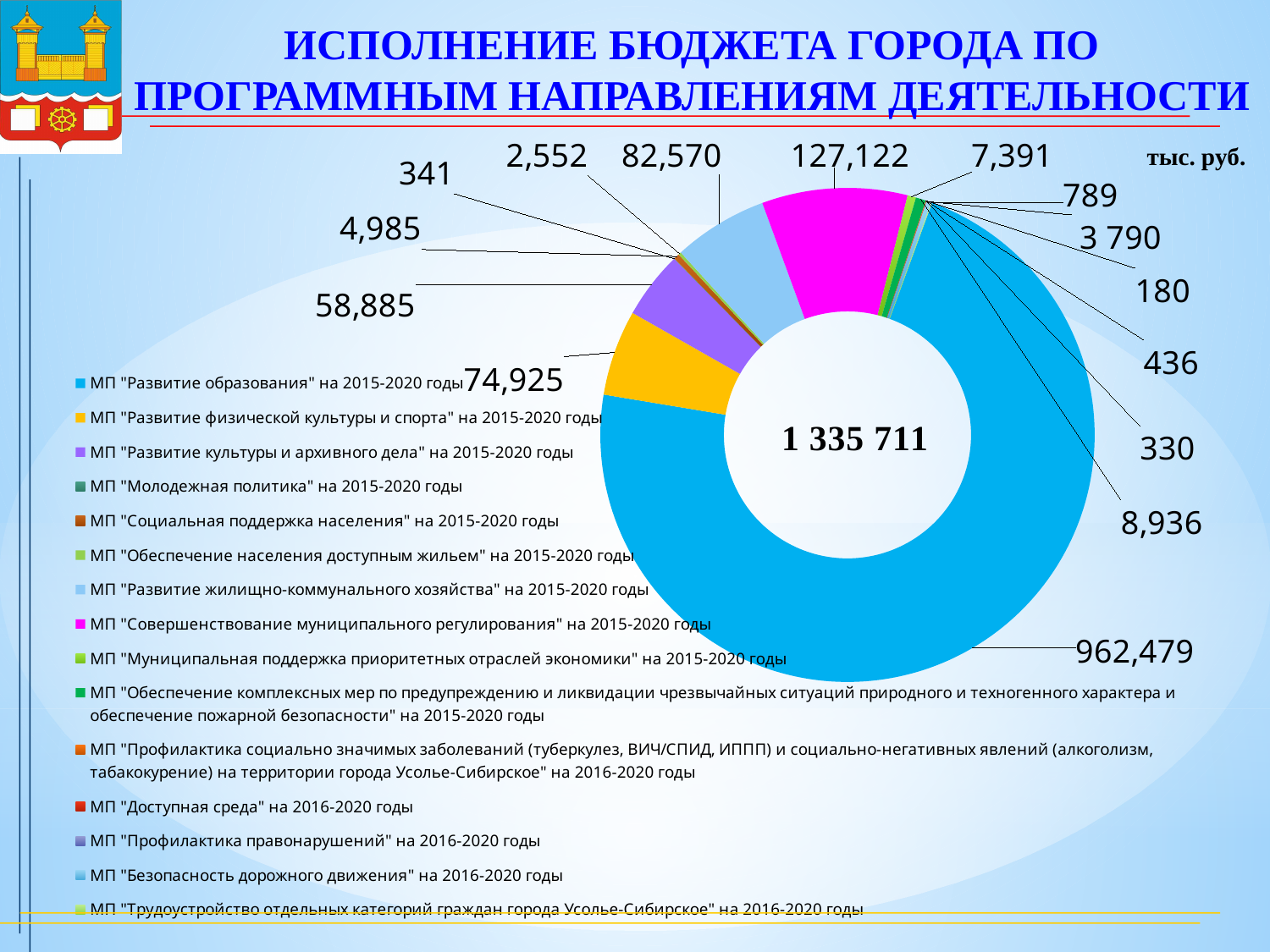
What is the smallest value printed on the chart? 180 What is the value for МП "Развитие жилищно-коммунального хозяйства" на 2015-2020 годы? 82,570 What total value is printed in the centre of the chart? 1 335 711 What is the value for МП "Развитие физической культуры и спорта" на 2015-2020 годы? 74,925 Which programme has the largest share of the budget? МП "Развитие образования" на 2015-2020 годы What unit is indicated for the values on the chart? тыс. руб. What is the difference between the values 127,122 and 82,570? 44,552 Which is larger: the value for МП "Развитие физической культуры и спорта" or МП "Развитие культуры и архивного дела"? МП "Развитие физической культуры и спорта" What is the value for МП "Развитие образования" на 2015-2020 годы? 962,479 What kind of chart is shown on the slide? Doughnut (pie) chart What is the value for МП "Совершенствование муниципального регулирования" на 2015-2020 годы? 127,122 How many programmes are listed in the legend? 15